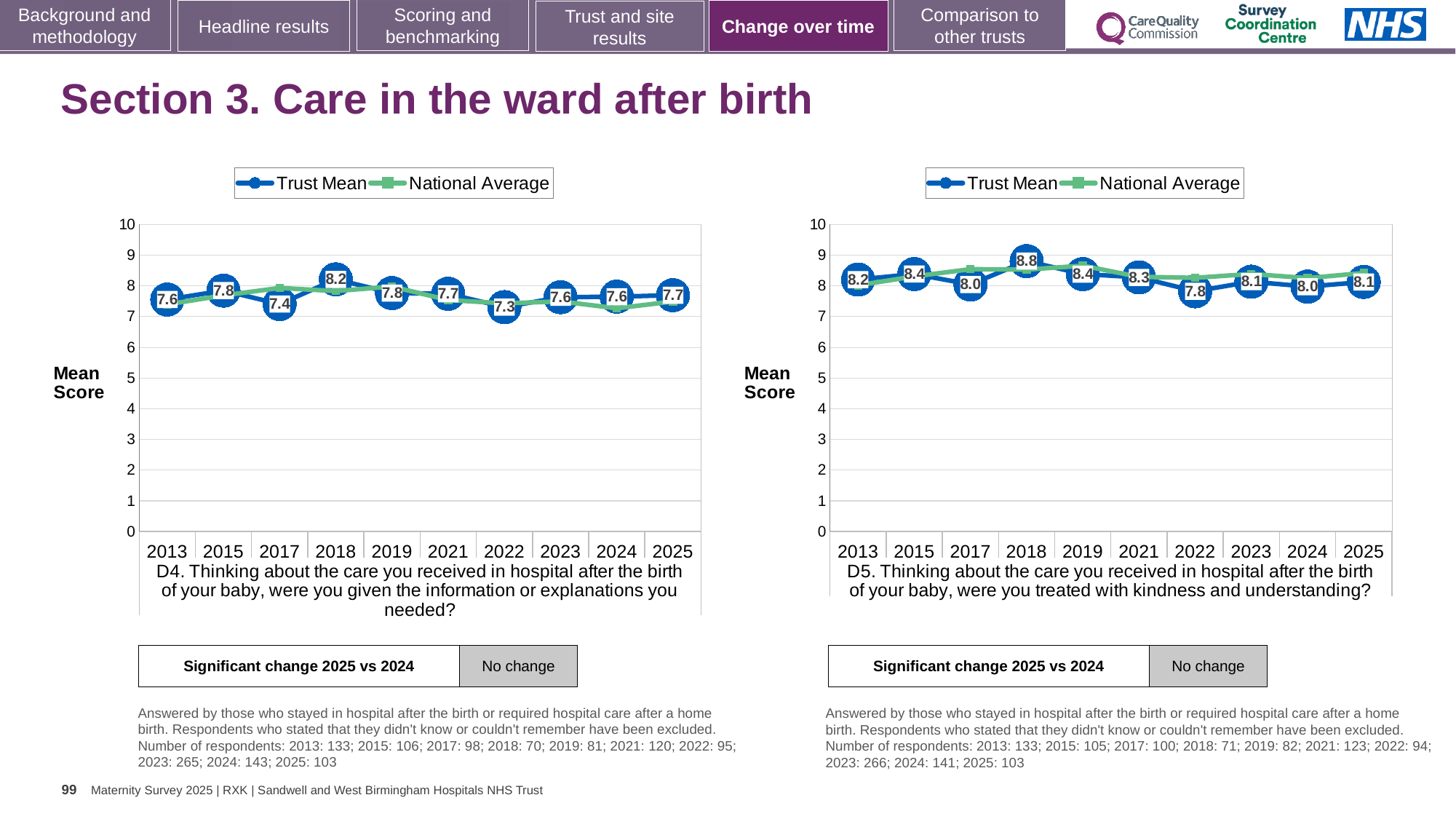
What kind of chart is the D5 chart? Line chart In the D5 chart, what is the Trust Mean for 2025? 8.1 In the D5 chart, what is the Trust Mean for 2018? 8.8 How many series does the legend of the D5 chart list? 2 In the D5 chart, is the Trust Mean higher in 2015 or in 2017? 2015 In the D4 chart, which year has the highest Trust Mean? 2018 In the D4 chart, what is the Trust Mean for 2022? 7.3 In the D5 chart, which year has the lowest Trust Mean? 2022 In the D4 chart, which year has the lowest Trust Mean? 2022 In the D4 chart, what is the difference between the Trust Mean in 2018 and in 2022? 0.9 In the D4 chart, what is the Trust Mean for 2018? 8.2 How many years are shown on the x axis of the D4 chart? 10